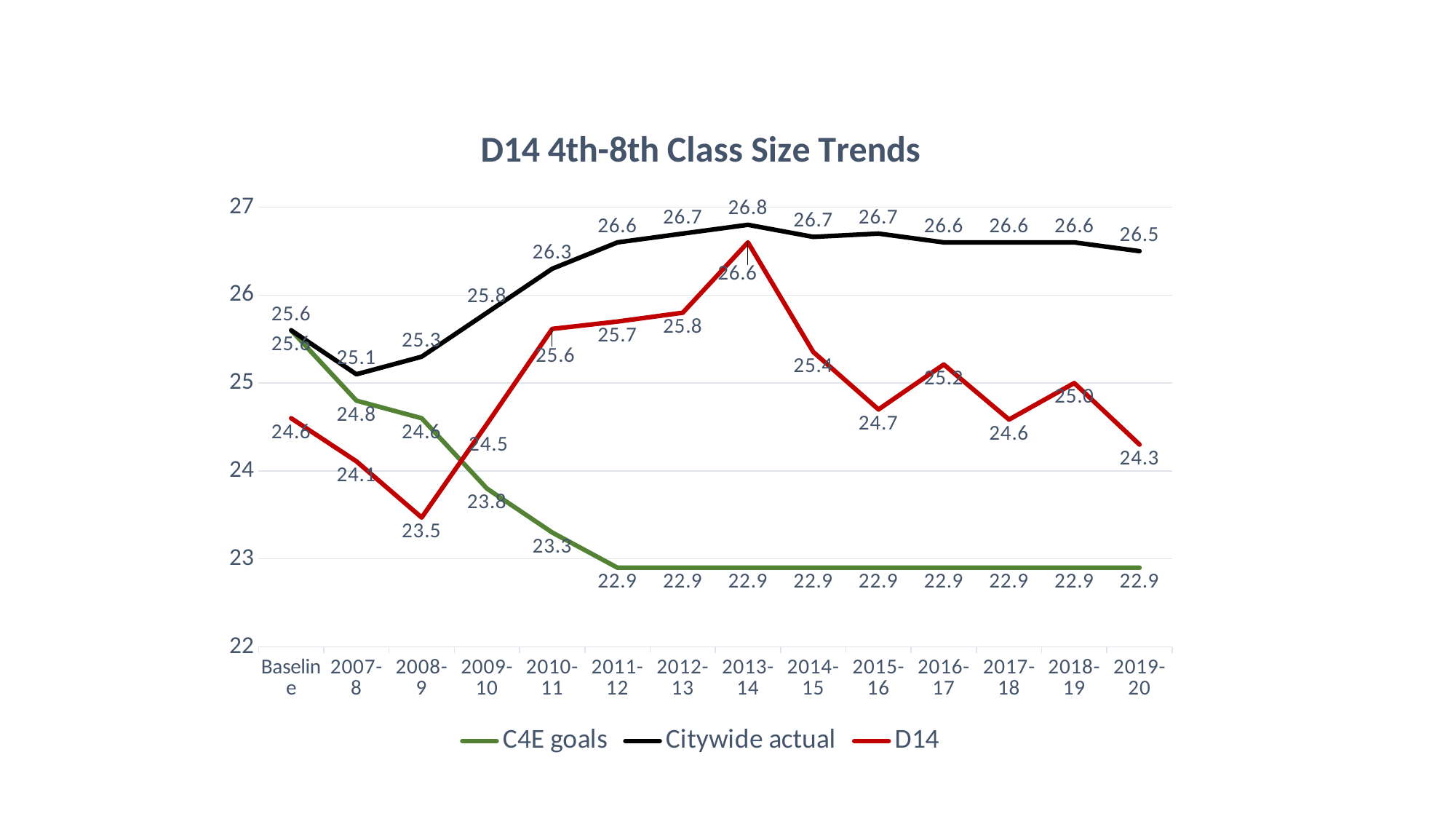
What is the D14 value for 2019-20? 24.3 How many series does the legend list? 3 Does the C4E goals series rise or fall from Baseline to 2011-12? fall In which year is the D14 value lowest? 2008-9 What is the Citywide actual value for 2013-14? 26.8 Which is larger in 2015-16, the Citywide actual value or the D14 value? Citywide actual What type of chart is shown on the slide? line chart What is the difference between the Citywide actual and D14 values in 2019-20? 2.2 In which year does the D14 series reach its highest value? 2013-14 How many points are plotted along the x axis for each series? 14 What is the title of the chart? D14 4th-8th Class Size Trends What is the C4E goals value for 2009-10? 23.8